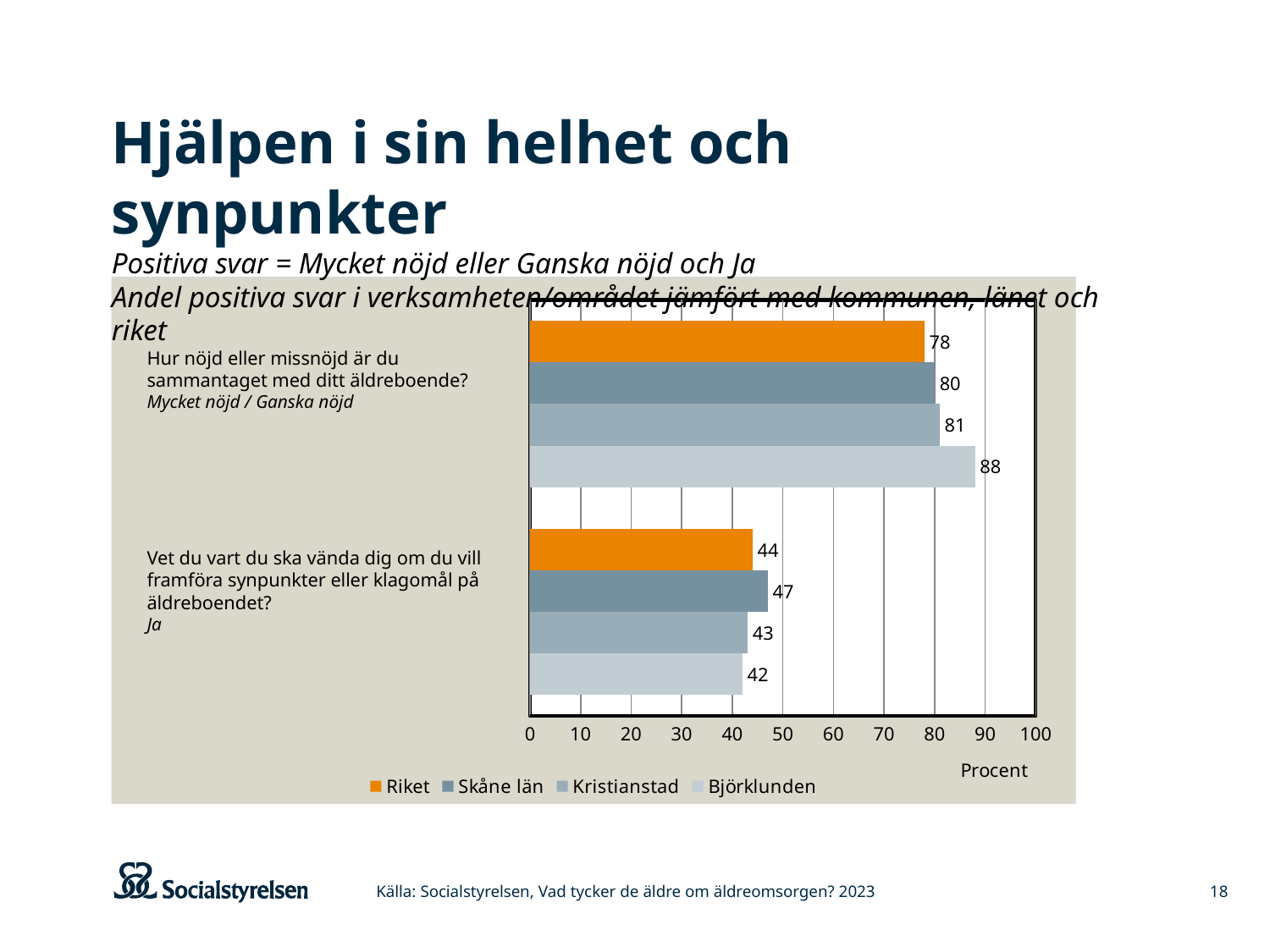
What is the value for Kristianstad on the question "Vet du vart du ska vända dig om du vill framföra synpunkter eller klagomål på äldreboendet?"? 43 What is the value for Skåne län on the question "Hur nöjd eller missnöjd är du sammantaget med ditt äldreboende?"? 80 Which is larger on the question "Vet du vart du ska vända dig om du vill framföra synpunkter eller klagomål på äldreboendet?": Skåne län or Kristianstad? Skåne län Which series has the highest value on the question "Hur nöjd eller missnöjd är du sammantaget med ditt äldreboende?"? Björklunden What kind of chart is shown on the slide? Bar chart What is the difference between Björklunden and Riket on the question "Hur nöjd eller missnöjd är du sammantaget med ditt äldreboende?"? 10 Is the value for Björklunden on the question "Vet du vart du ska vända dig om du vill framföra synpunkter eller klagomål på äldreboendet?" greater or less than 50? less Which series has the lowest value on the question "Vet du vart du ska vända dig om du vill framföra synpunkter eller klagomål på äldreboendet?"? Björklunden How many series does the legend list? 4 What is the value for Björklunden on the question "Hur nöjd eller missnöjd är du sammantaget med ditt äldreboende?"? 88 What is the label on the horizontal axis of the chart? Procent What is the value for Riket on the question "Vet du vart du ska vända dig om du vill framföra synpunkter eller klagomål på äldreboendet?"? 44